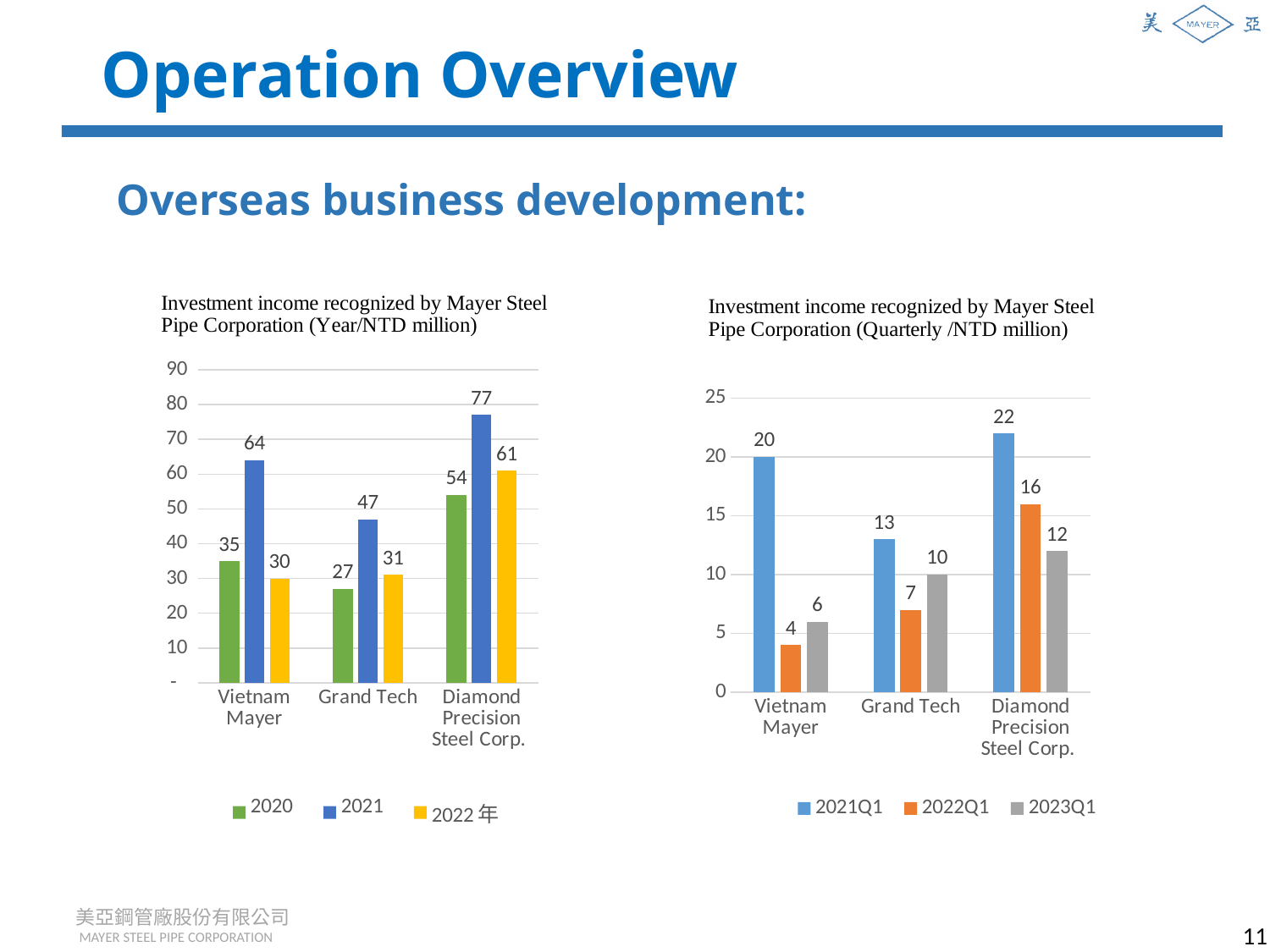
In the yearly chart on the left, how many series does the legend list? 3 In the yearly chart on the left, what is the 2021 value for Vietnam Mayer? 64 In the yearly chart on the left, which company has the highest 2021 value? Diamond Precision Steel Corp. In the quarterly chart on the right, what is the difference between the 2021Q1 and 2023Q1 values for Diamond Precision Steel Corp.? 10 In the yearly chart on the left, what is the 2022 value for Diamond Precision Steel Corp.? 61 In the quarterly chart on the right, what is the 2021Q1 value for Diamond Precision Steel Corp.? 22 In the yearly chart on the left, which company has the lowest 2020 value? Grand Tech In the yearly chart on the left, what is the difference between the 2021 and 2022 values for Vietnam Mayer? 34 In the quarterly chart on the right, which is larger for Grand Tech: the 2022Q1 value or the 2023Q1 value? 2023Q1 In the quarterly chart on the right, how many companies are shown on the x axis? 3 What type of chart is the quarterly chart on the right? Bar chart In the quarterly chart on the right, what is the 2022Q1 value for Vietnam Mayer? 4